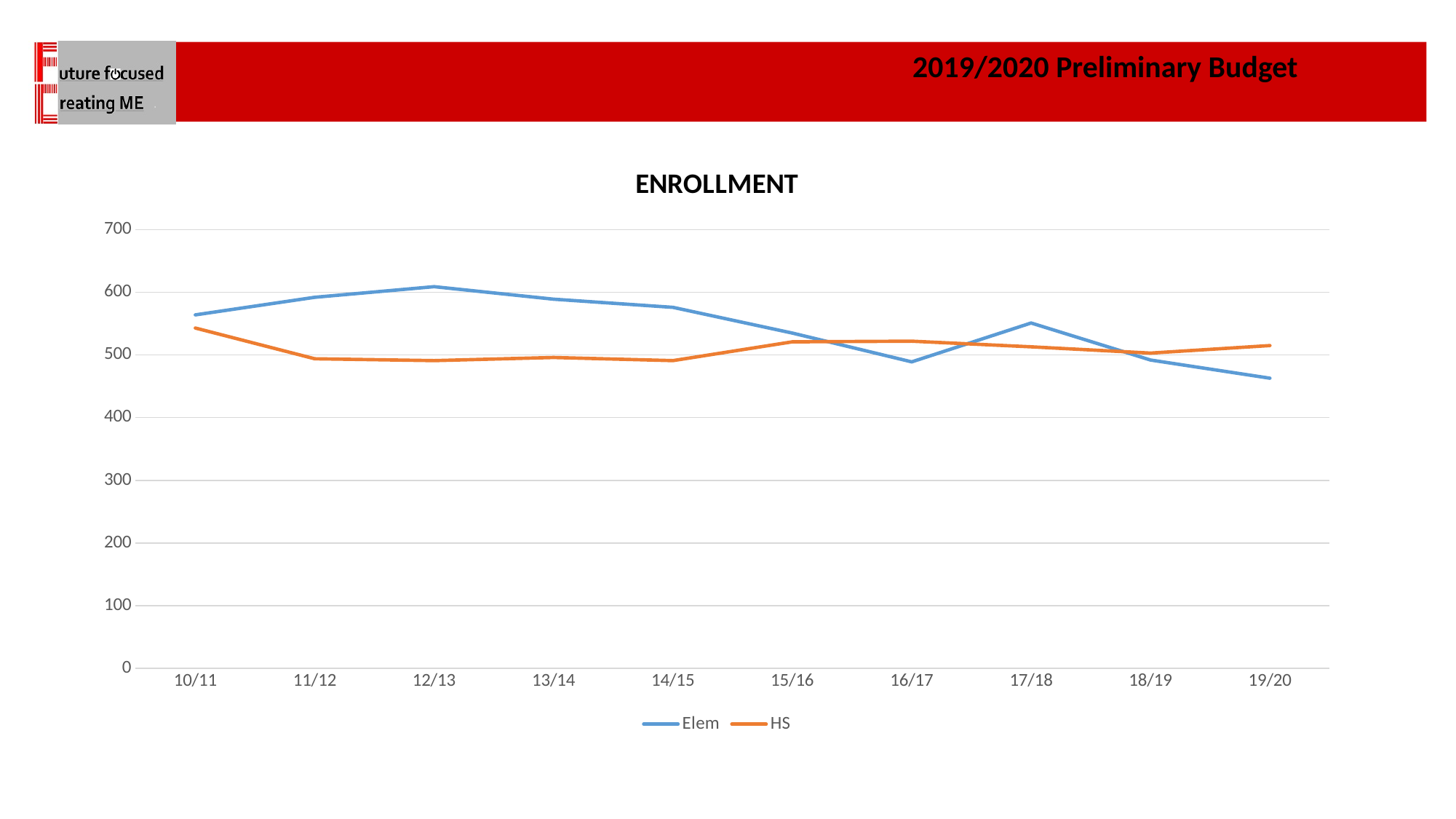
How many series does the legend list? 2 In which year does the Elem series reach its lowest value? 19/20 Which series is drawn in orange? HS What kind of chart is shown on the slide? line chart What is the title of the chart? ENROLLMENT How many school years are plotted along the x axis? 10 In 19/20, which series has the larger value, Elem or HS? HS In which year does the Elem series reach its highest value? 12/13 Is the HS value for 15/16 greater or less than 500? greater In which year does the HS series reach its highest value? 10/11 In 10/11, which series has the larger value, Elem or HS? Elem Is the Elem value for 19/20 greater or less than 500? less